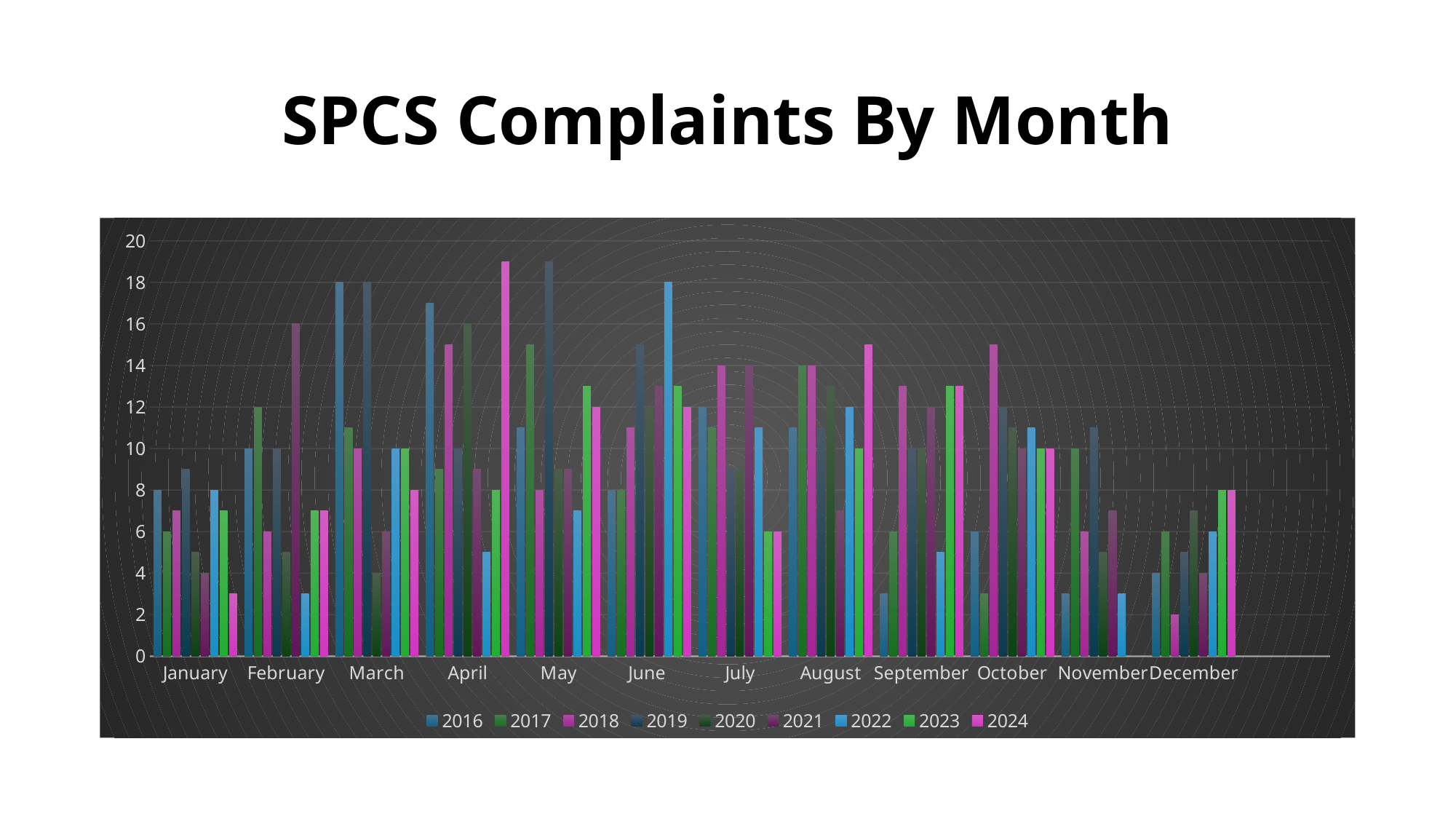
Is the value for 2024 in January greater or less than 4? less How many months are shown along the x axis? 12 Which is larger in June, the value for 2022 or the value for 2016? 2022 Is the value for 2024 in April greater or less than 18? greater How many series does the legend list? 9 What is the value for 2018 in February? 6 What kind of chart is shown on the slide? bar chart Which year is the last entry in the legend? 2024 What is the value for 2016 in March? 18 Is the value for 2018 in December greater or less than 4? less What is the value for 2022 in June? 18 What is the title of the chart? SPCS Complaints By Month